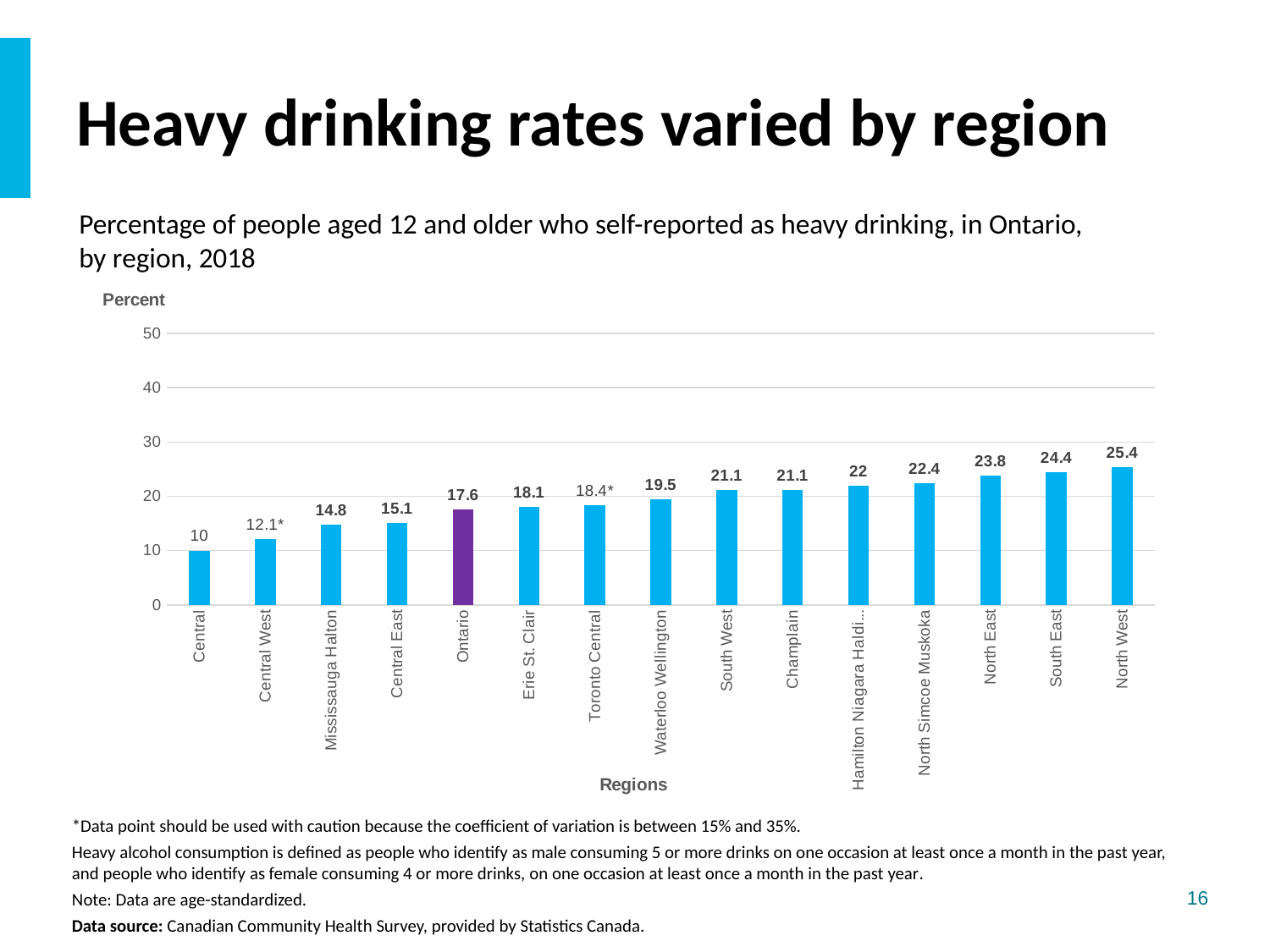
Which is larger, the value for South East or the value for North Simcoe Muskoka? South East Is the value for Mississauga Halton greater or less than 20? less What is the value shown for Central West? 12.1* How many bars are shown in the chart? 15 What is the difference between the values for North East and Central East? 8.7 Which region has the lowest heavy drinking rate? Central What kind of chart is shown on the slide? Bar chart Which bar is shown in a different colour (purple) from the others? Ontario What is the heavy drinking rate for North West? 25.4 What is the value shown for Waterloo Wellington? 19.5 Which region has the highest heavy drinking rate? North West What is the value shown for Ontario? 17.6